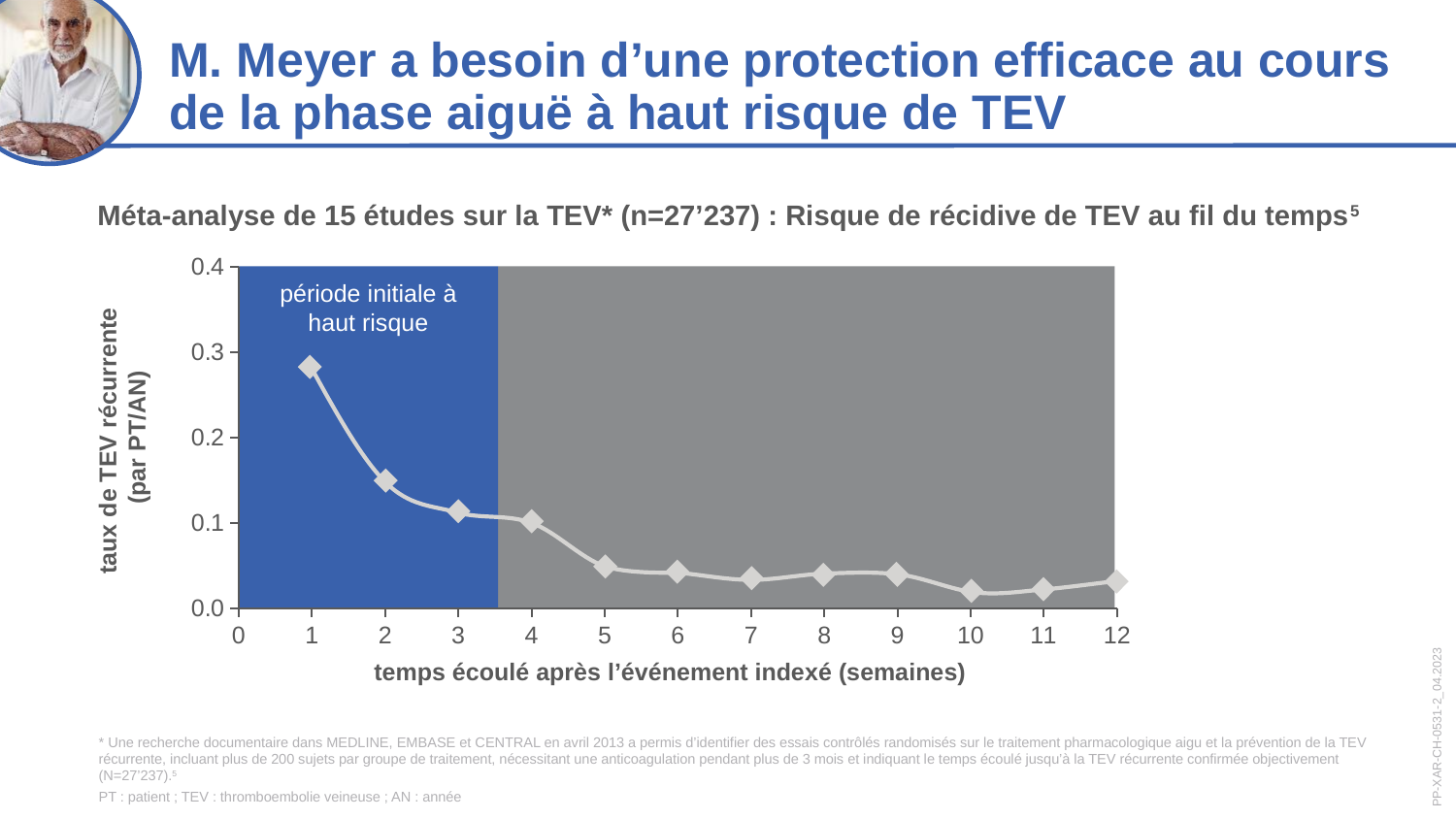
Is the value at week 1 greater or less than 0.2? greater Is the value at week 2 greater or less than 0.2? less What kind of chart is shown on the slide? line chart What label is written in the blue shaded area of the chart? période initiale à haut risque At which week is the recurrent VTE rate highest? 1 Is the value at week 2 greater or less than 0.1? greater What is the label of the x axis? temps écoulé après l’événement indexé (semaines) How many data points are plotted on the line? 12 Do the values rise or fall as the number of weeks after the index event increases? fall Which is larger, the value at week 1 or the value at week 12? week 1